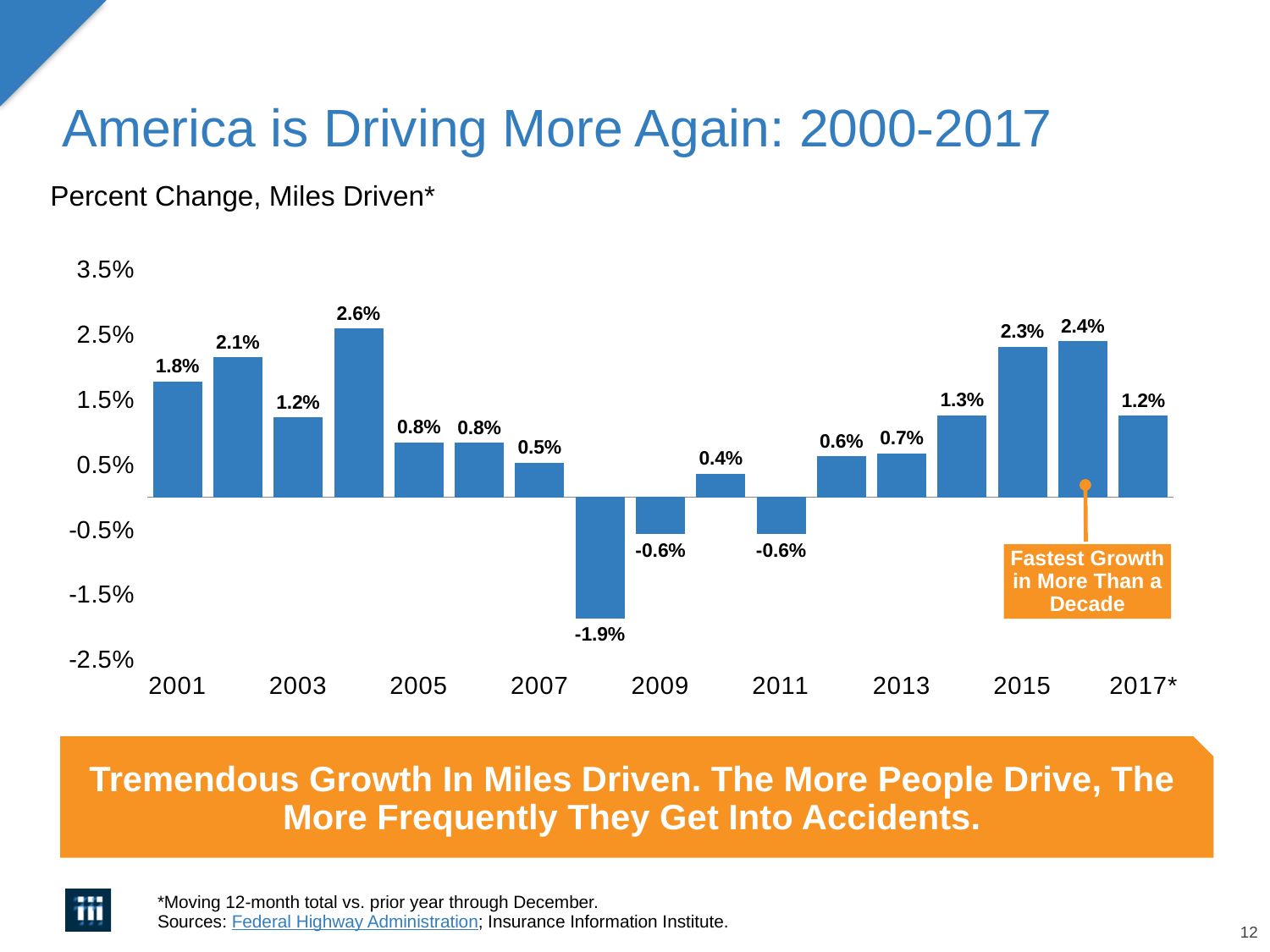
What is the percent change in miles driven for 2017*? 1.2% Which year has the larger percent change, 2001 or 2003? 2001 What is the percent change in miles driven for 2001? 1.8% What is the percent change in miles driven for 2015? 2.3% What is the lowest percent change value shown on the chart? -1.9% What type of chart is shown on the slide? bar chart What is the percent change in miles driven for 2013? 0.7% How many bars are plotted on the chart? 17 What does the orange callout box on the chart say? Fastest Growth in More Than a Decade Is the value for 2007 greater or less than 1.5%? less What is the difference between the values for 2015 and 2017*? 1.1% What is the highest percent change value shown on the chart? 2.6%